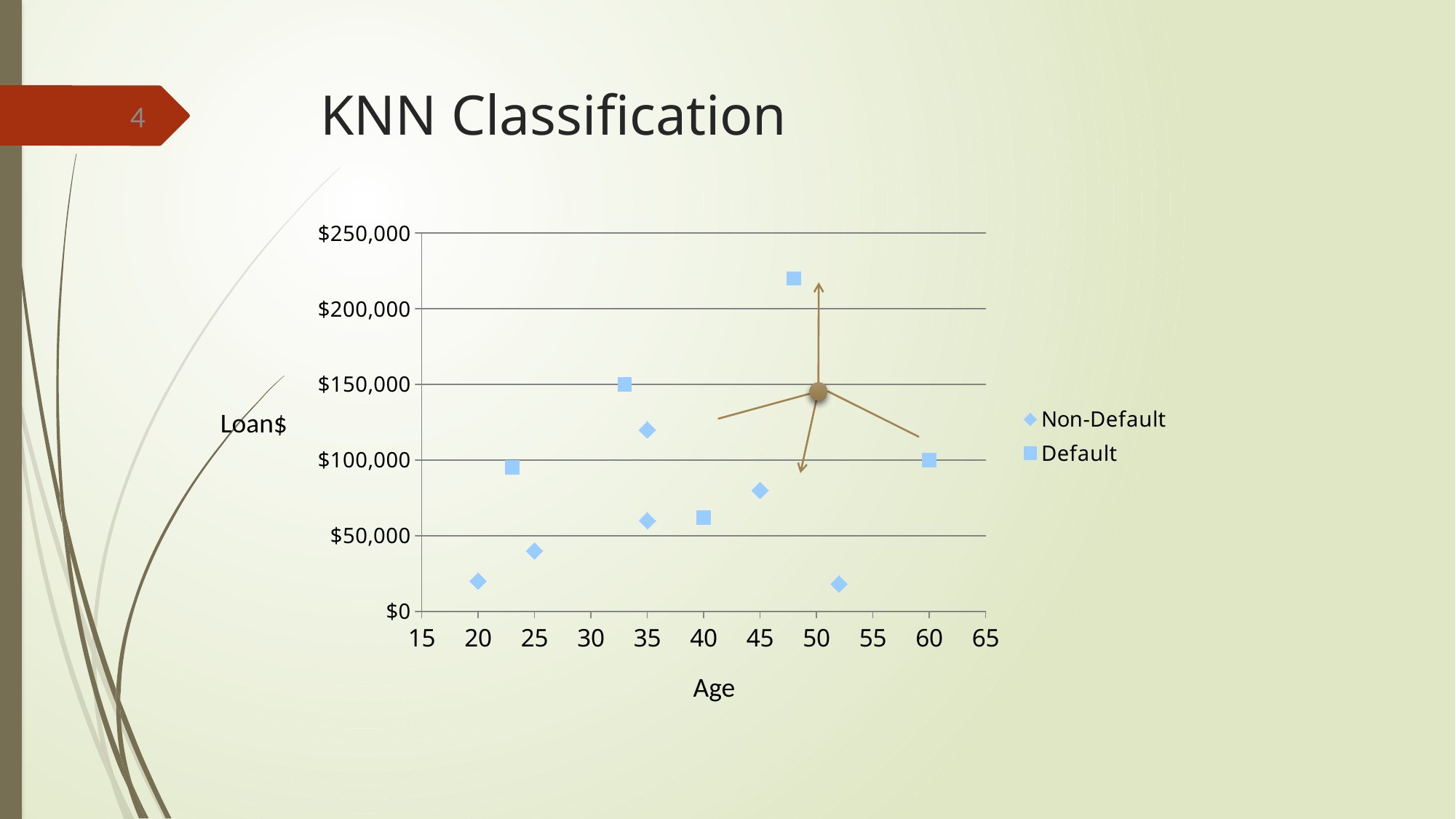
How many series does the legend list? 2 Is the loan value for the Default point at about age 48 greater or less than $200,000? greater How many data points are plotted in total across both series? 11 How many Default points are plotted on the chart? 5 What kind of chart is shown on the slide? scatter chart Is the loan value for the Non-Default point at age 20 greater or less than $50,000? less What are the two series named in the legend? Non-Default and Default Which series contains the point with the highest loan value? Default What is the title of the chart's vertical axis? Loan$ How many Non-Default points are plotted on the chart? 6 Which has the larger loan value: the Default point at age 60 or the Non-Default point at age 45? the Default point at age 60 Is the loan value for the Non-Default point at age 45 greater or less than $100,000? less